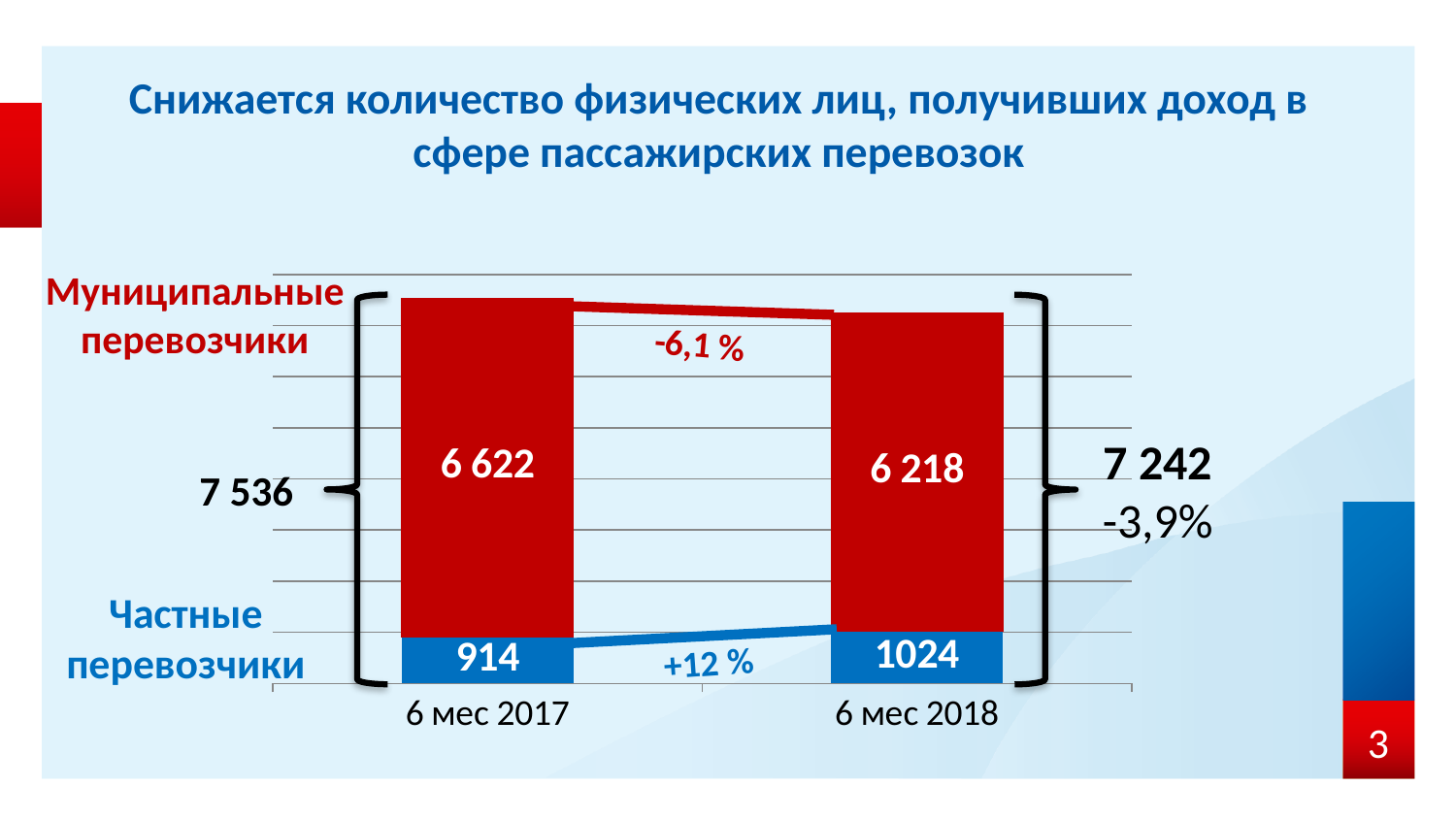
What is the value for Частные перевозчики in 6 мес 2018? 1024 What is the total of the stacked bar for 6 мес 2018? 7 242 What is the value for Муниципальные перевозчики in 6 мес 2017? 6 622 What percentage change is shown for Частные перевозчики between the two periods? +12 % What type of chart is shown on the slide? stacked bar chart Which is larger: Частные перевозчики in 6 мес 2017 or in 6 мес 2018? 6 мес 2018 What is the difference between the Муниципальные перевозчики values for 6 мес 2017 and 6 мес 2018? 404 Does the value for Муниципальные перевозчики rise or fall from 6 мес 2017 to 6 мес 2018? fall How many categories are shown on the x axis? 2 What is the value for Муниципальные перевозчики in 6 мес 2018? 6 218 What is the total of the stacked bar for 6 мес 2017? 7 536 What is the value for Частные перевозчики in 6 мес 2017? 914